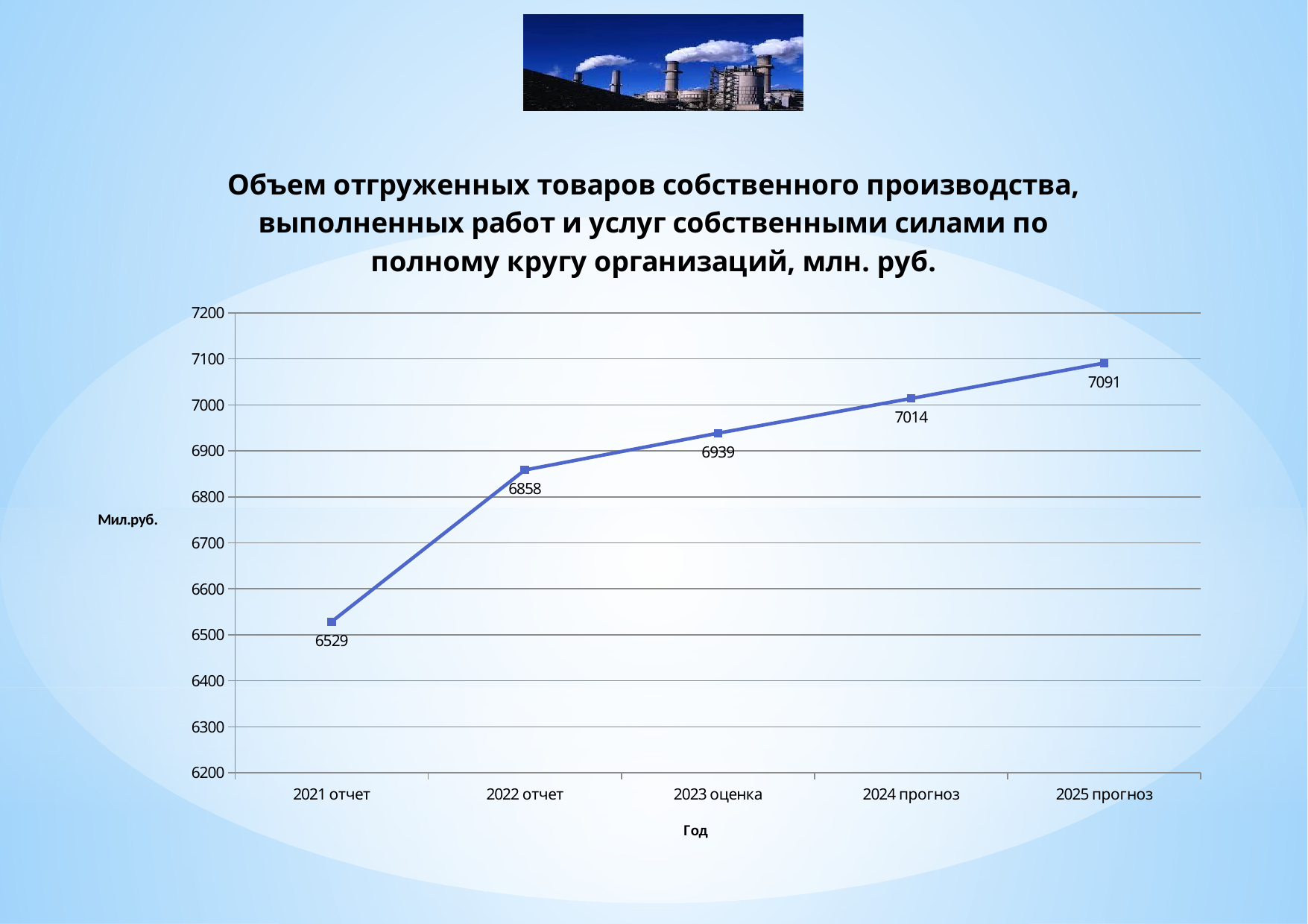
Is the value for 2022 отчет greater or less than 6800? greater Which is larger, the value for 2023 оценка or the value for 2024 прогноз? 2024 прогноз Which year has the lowest value? 2021 отчет What is the difference between the values for 2022 отчет and 2021 отчет? 329 What is the value for 2023 оценка? 6939 Do the values rise or fall from 2021 отчет to 2025 прогноз? rise How many data points are plotted on the chart? 5 Which year has the highest value? 2025 прогноз What is the difference between the values for 2025 прогноз and 2024 прогноз? 77 What is the value for 2021 отчет? 6529 What kind of chart is shown on the slide? line chart What is the value for 2025 прогноз? 7091